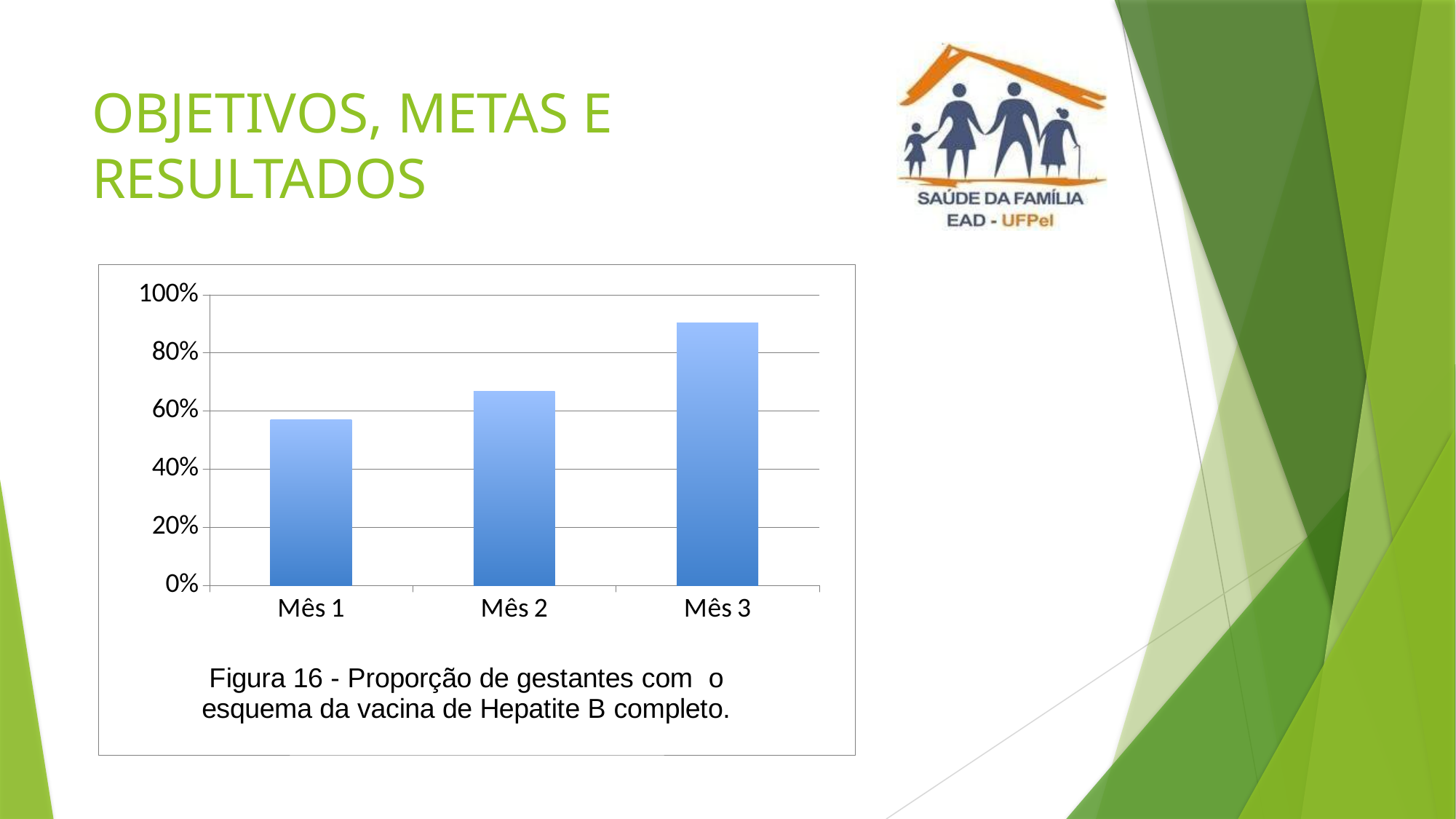
Is the value for Mês 2 greater or less than 60%? greater Is the value for Mês 3 greater or less than 80%? greater What is the figure caption shown below the chart? Figura 16 - Proporção de gestantes com o esquema da vacina de Hepatite B completo. Which is larger, the value for Mês 2 or the value for Mês 3? Mês 3 Which month has the highest value on the chart? Mês 3 Is the value for Mês 1 greater or less than 40%? greater Do the values rise or fall from Mês 1 to Mês 3? rise How many categories (months) are plotted on the chart? 3 What kind of chart is shown on the slide? bar chart Which month has the lowest value on the chart? Mês 1 Which is larger, the value for Mês 1 or the value for Mês 2? Mês 2